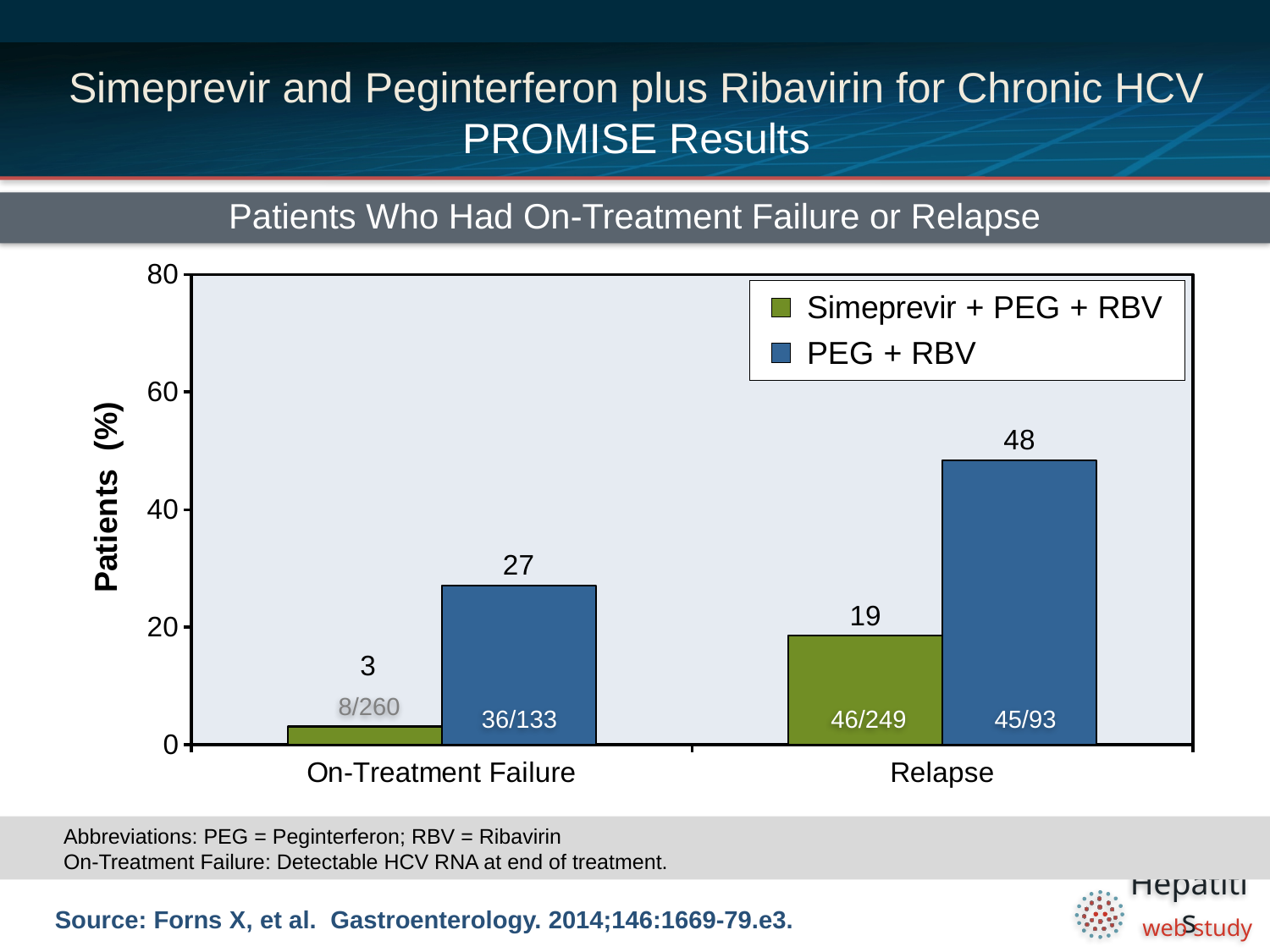
Which bar has the highest value on the chart? PEG + RBV, Relapse Which is larger: the Simeprevir + PEG + RBV value for Relapse or the PEG + RBV value for On-Treatment Failure? PEG + RBV for On-Treatment Failure Which bar has the lowest value on the chart? Simeprevir + PEG + RBV, On-Treatment Failure What is the value for PEG + RBV in the Relapse category? 48 How many series does the legend list? 2 What is the difference between the PEG + RBV and Simeprevir + PEG + RBV values in the On-Treatment Failure category? 24 What is the value for Simeprevir + PEG + RBV in the Relapse category? 19 What kind of chart is shown on the slide? Bar chart What is the value for Simeprevir + PEG + RBV in the On-Treatment Failure category? 3 What is the difference between the PEG + RBV and Simeprevir + PEG + RBV values in the Relapse category? 29 How many categories are shown on the x axis? 2 What is the value for PEG + RBV in the On-Treatment Failure category? 27